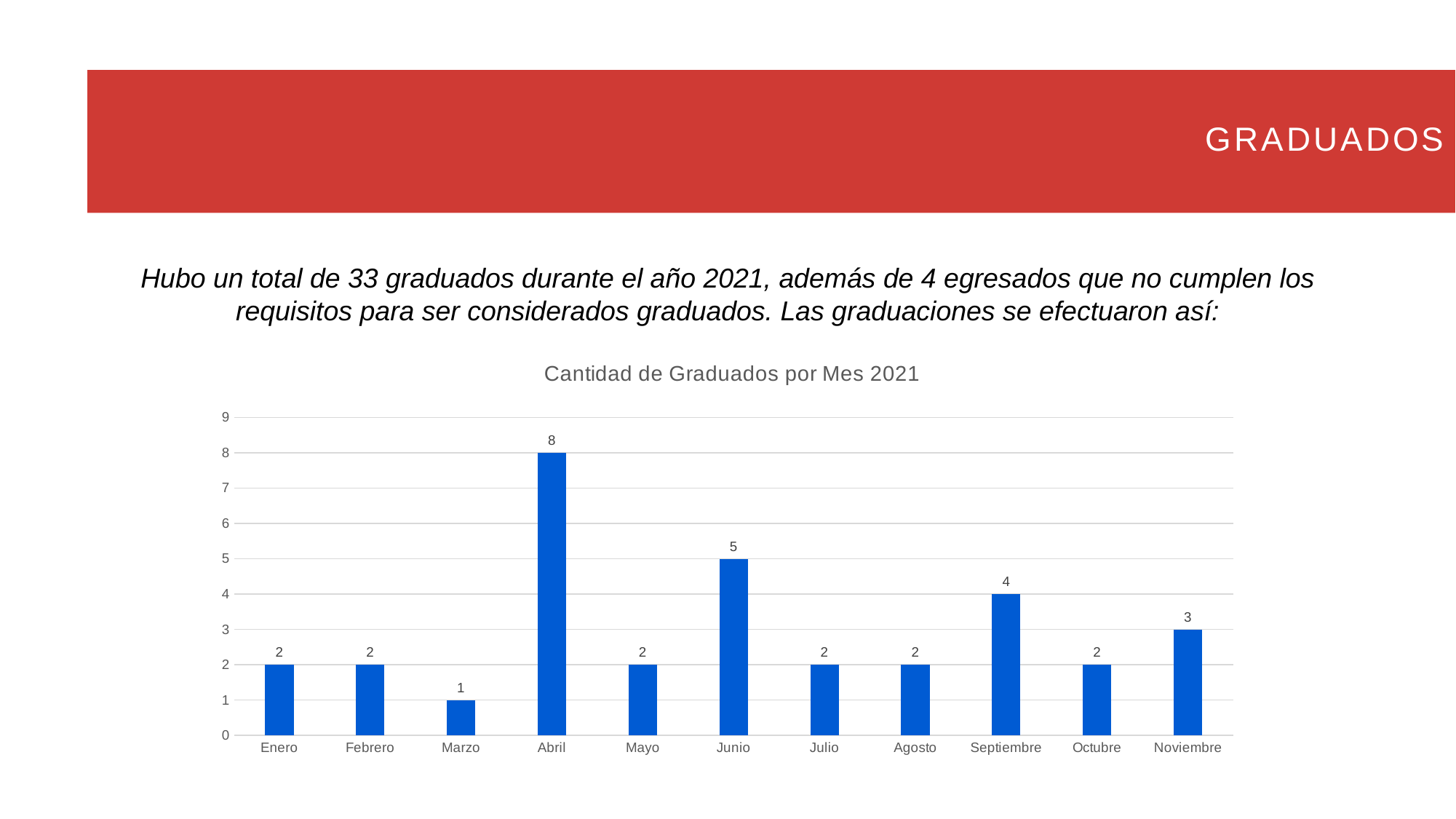
What is the value for Abril? 8 Which month has the lowest value? Marzo What is the value for Noviembre? 3 Is the value for Abril greater or less than 7? greater What is the value for Septiembre? 4 How many months have a value of 2? 6 What is the difference between the values for Abril and Junio? 3 What kind of chart is this? bar chart What is the title of the chart? Cantidad de Graduados por Mes 2021 How many months are shown on the x axis? 11 Which month has the highest value? Abril Which is larger, the value for Junio or the value for Septiembre? Junio